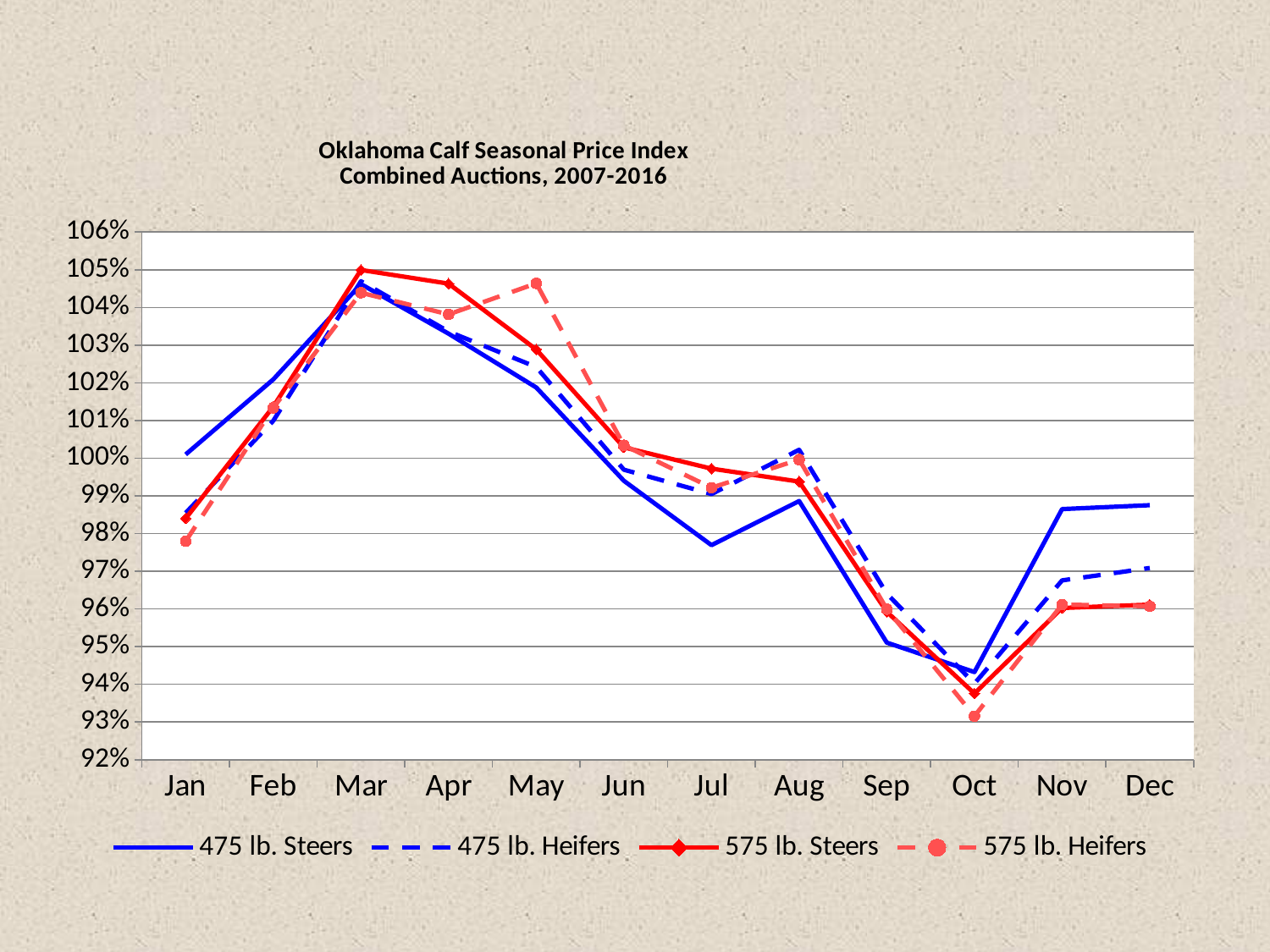
In which month does the 575 lb. Heifers series reach its lowest value? Oct What kind of chart is shown on the slide? line chart Is the value for 575 lb. Heifers in Oct greater or less than 94%? less In which month does the 575 lb. Steers series reach its highest value? Mar Does the 575 lb. Steers series rise or fall from Mar to Oct? fall In which month does the 475 lb. Steers series reach its lowest value? Oct In Jan, which series has the higher value: 475 lb. Steers or 575 lb. Heifers? 475 lb. Steers In Dec, which series has the higher value: 475 lb. Steers or 575 lb. Steers? 475 lb. Steers Is the value for 575 lb. Steers in Mar greater or less than 104%? greater How many series does the legend list? 4 How many months are plotted along the x axis? 12 Is the value for 475 lb. Steers in Nov greater or less than 98%? greater